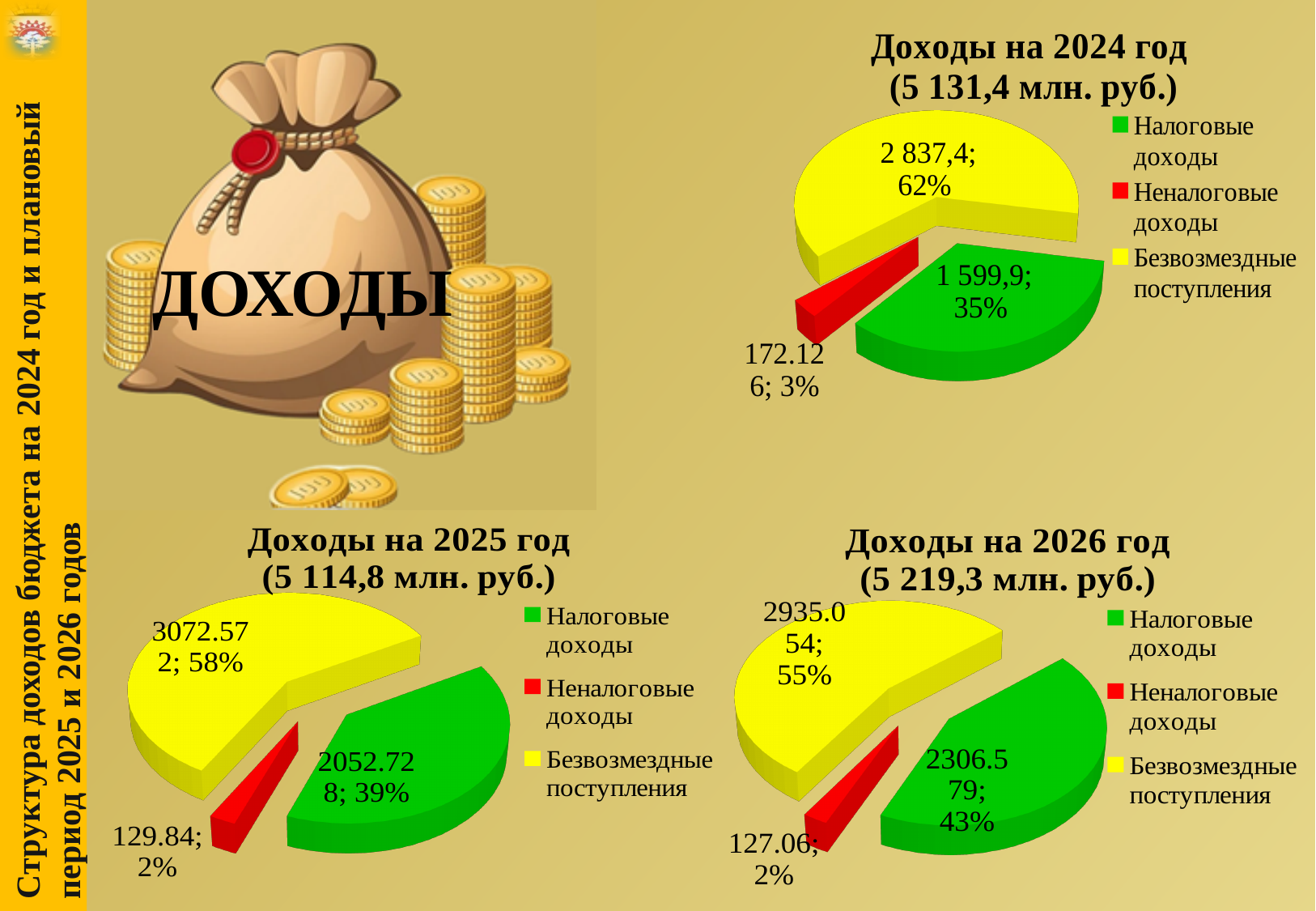
In the chart titled "Доходы на 2025 год", what is the value for Безвозмездные поступления? 3072.572 What kind of chart is the chart titled "Доходы на 2024 год"? Pie chart In the chart titled "Доходы на 2024 год", what is the value for Налоговые доходы? 1 599,9 In the chart titled "Доходы на 2025 год", which category has the largest slice? Безвозмездные поступления In the chart titled "Доходы на 2025 год", what share of the pie is Налоговые доходы? 39% In the chart titled "Доходы на 2026 год", what share of the pie is Налоговые доходы? 43% In the chart titled "Доходы на 2024 год", which category has the smallest slice? Неналоговые доходы In the chart titled "Доходы на 2024 год", what share of the pie is Безвозмездные поступления? 62% In the chart titled "Доходы на 2026 год", what is the value for Неналоговые доходы? 127.06 In the chart titled "Доходы на 2026 год", which colour represents Неналоговые доходы? Red In the chart titled "Доходы на 2026 год", which is larger, Налоговые доходы or Безвозмездные поступления? Безвозмездные поступления How many categories does the legend of the chart titled "Доходы на 2025 год" list? 3